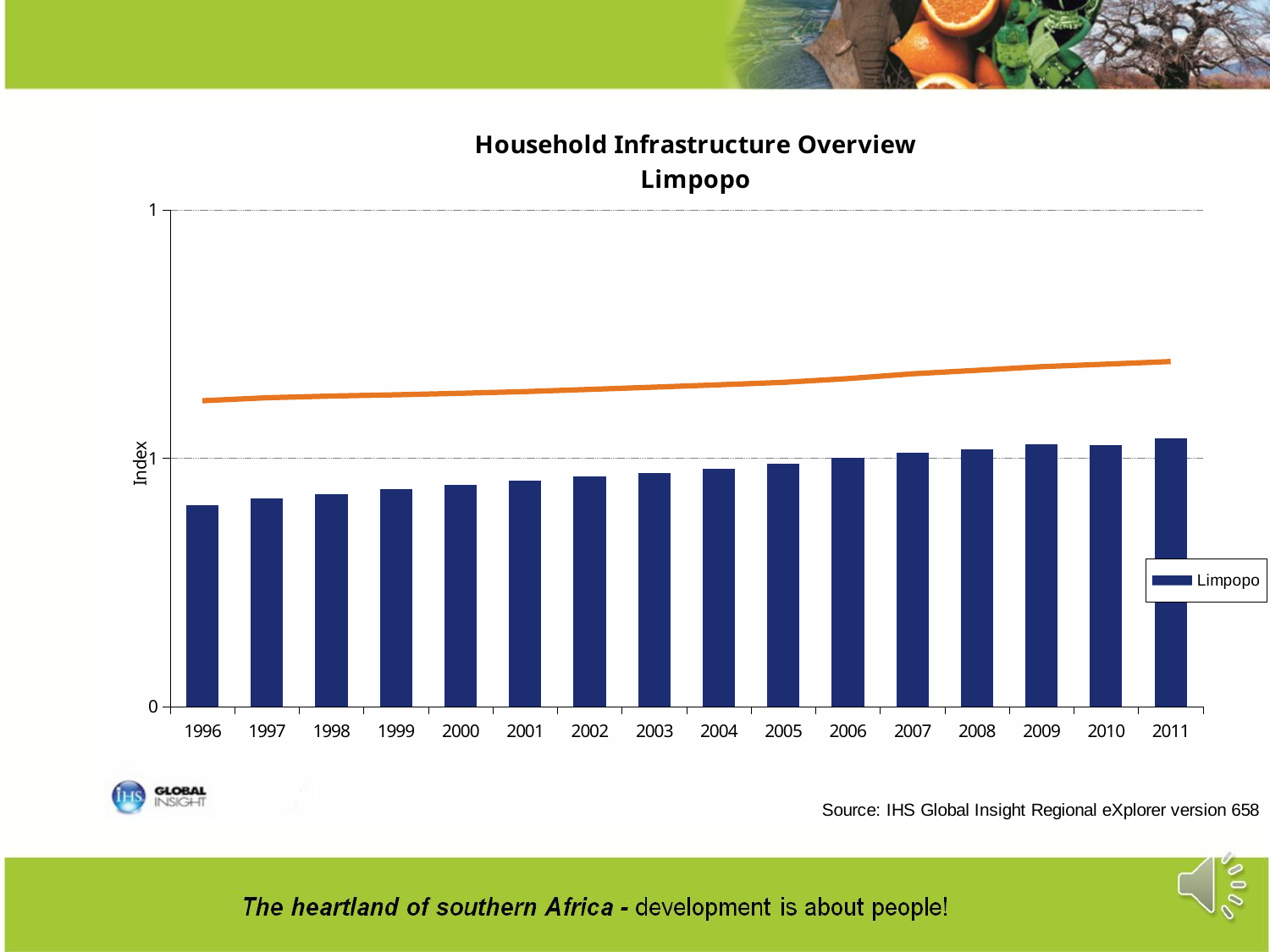
How many years are shown on the x axis of the chart? 16 How many series does the legend list? 1 Which year has the lowest bar? 1996 Which year has the highest bar? 2011 Which year has the larger bar, 1998 or 2005? 2005 What kind of chart is shown on the slide? combination bar and line chart What is the title of the chart? Household Infrastructure Overview Limpopo What is the name of the series listed in the legend? Limpopo Is the value for 2001 greater or less than 1? less Is the value for 1996 greater or less than 1? less Do the bar values rise or fall from 1996 to 2011? rise